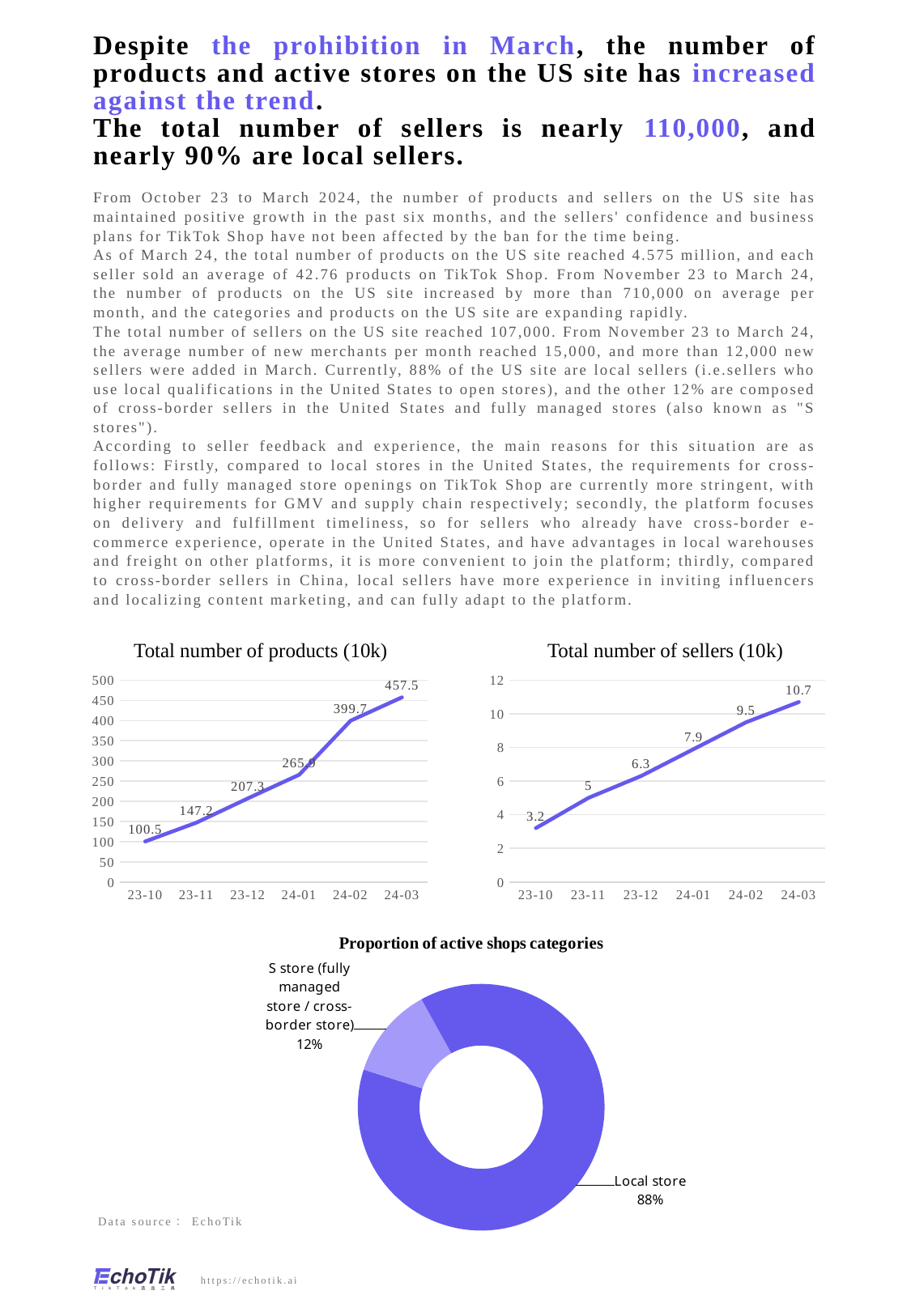
In the 'Total number of products (10k)' chart, what is the value for 24-03? 457.5 What kind of chart is 'Total number of sellers (10k)'? line chart In the 'Total number of products (10k)' chart, do the values rise or fall from 23-10 to 24-03? rise In the 'Total number of sellers (10k)' chart, what is the value for 23-11? 5 In the 'Total number of sellers (10k)' chart, what is the value for 24-03? 10.7 In the 'Total number of sellers (10k)' chart, how many data points are plotted? 6 In the 'Proportion of active shops categories' chart, what share does Local store have? 88% In the 'Total number of products (10k)' chart, which month has the lowest value? 23-10 In the 'Total number of products (10k)' chart, what is the difference between the values for 24-02 and 24-01? 133.8 In the 'Proportion of active shops categories' chart, which category has the smaller share? S store (fully managed store / cross-border store) In the 'Total number of sellers (10k)' chart, what is the difference between the values for 24-03 and 23-10? 7.5 In the 'Total number of products (10k)' chart, what is the value for 23-12? 207.3